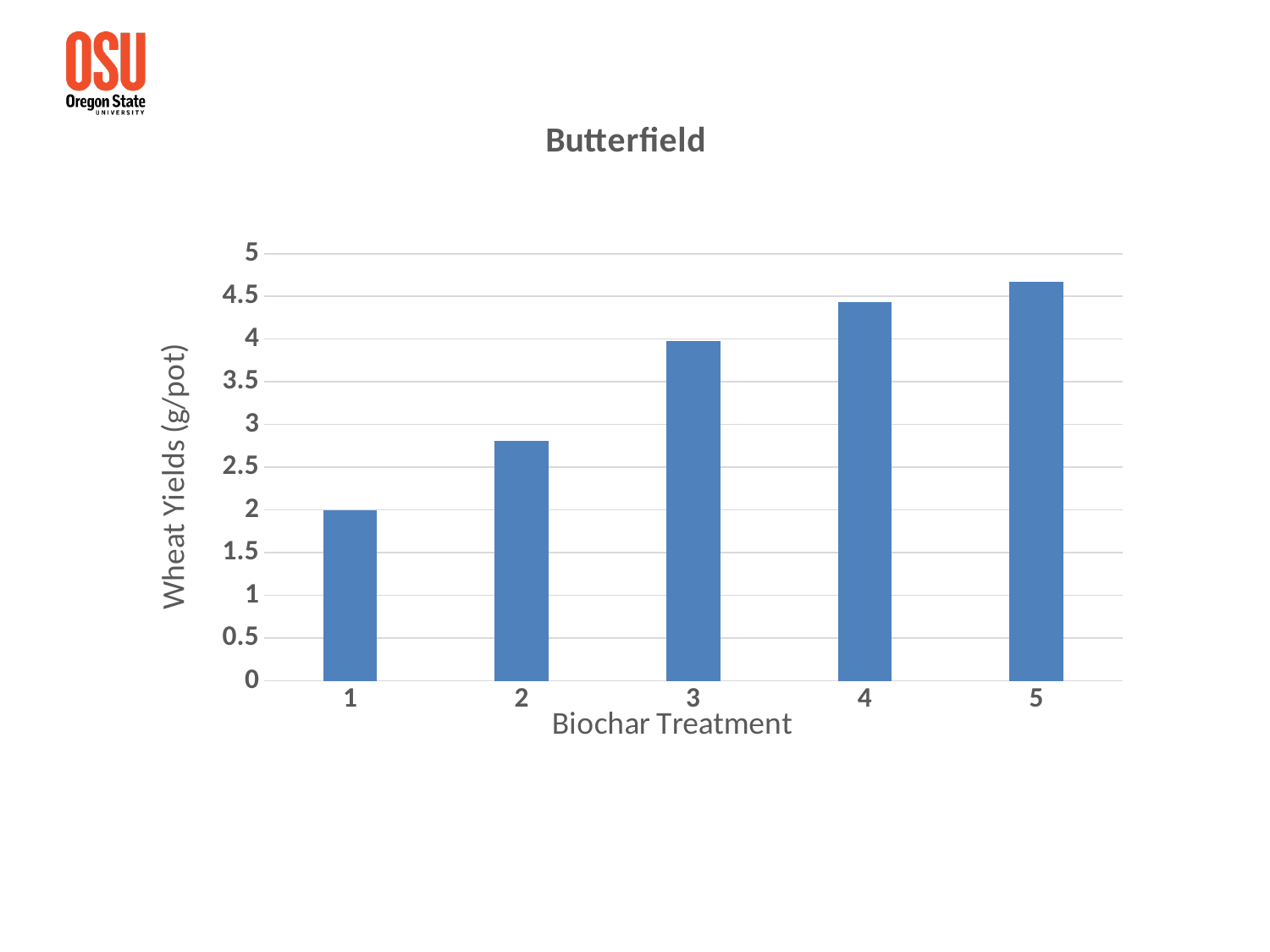
What kind of chart is shown on the slide? bar chart What is the label of the y axis? Wheat Yields (g/pot) Do wheat yields rise or fall as the biochar treatment number increases from 1 to 5? rise Which biochar treatment has the highest wheat yield? 5 How many biochar treatments are plotted on the chart? 5 Which biochar treatment has the lowest wheat yield? 1 Is the wheat yield for biochar treatment 4 greater or less than 4 g/pot? greater What is the title of the chart? Butterfield Is the wheat yield for biochar treatment 5 greater or less than 5 g/pot? less Is the wheat yield for biochar treatment 3 greater or less than 3.5 g/pot? greater Which has the larger wheat yield, biochar treatment 2 or biochar treatment 3? 3